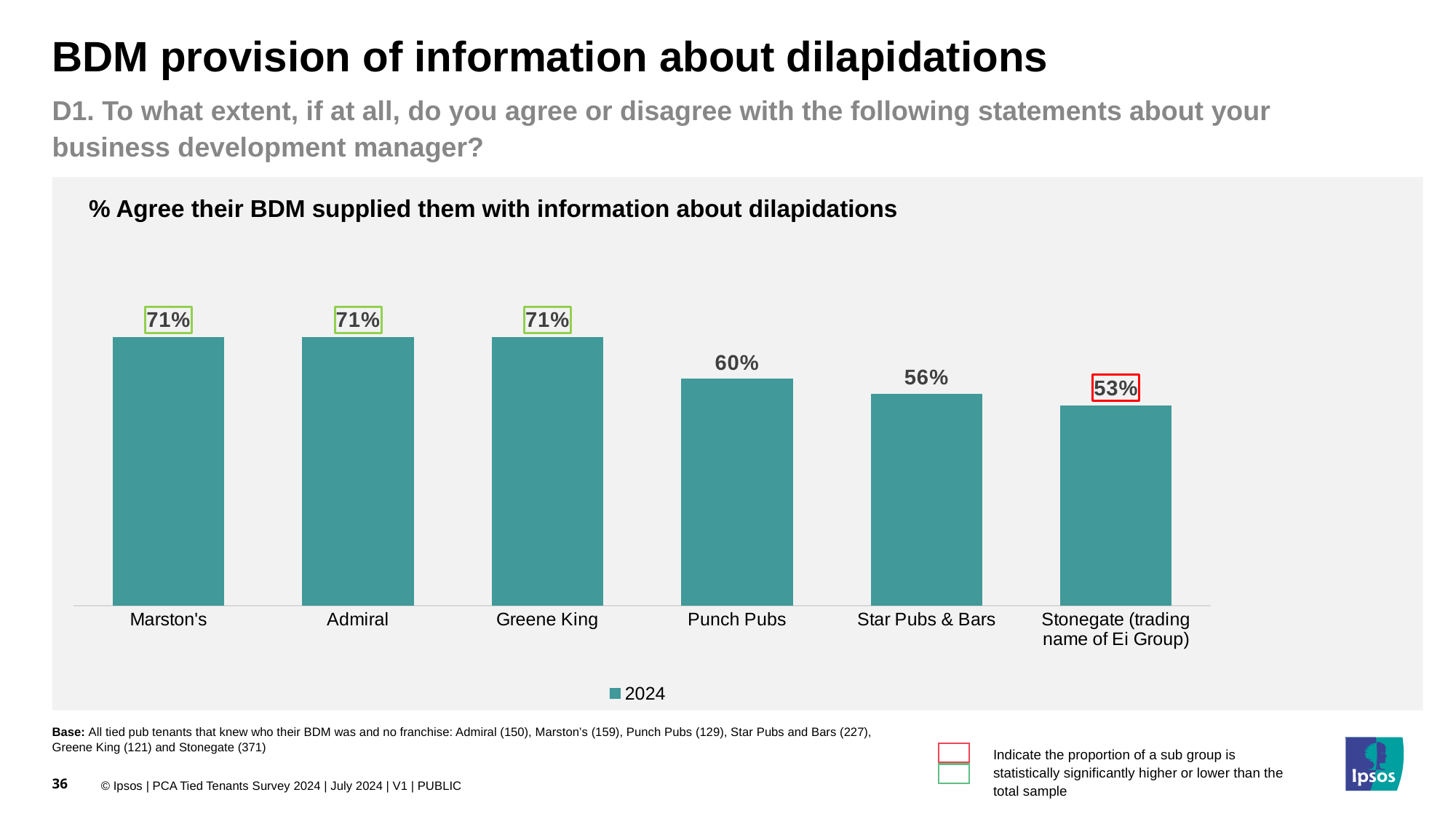
What is the value for Admiral? 71% Which is larger, the value for Greene King or the value for Punch Pubs? Greene King What is the value for Star Pubs & Bars? 56% What is the value for Punch Pubs? 60% What is the difference between the values for Punch Pubs and Star Pubs & Bars? 4% How many categories are shown on the x axis? 6 What kind of chart is shown? Bar chart How many series does the legend list? 1 What is the value for Stonegate (trading name of Ei Group)? 53% What is the difference between the values for Marston's and Stonegate (trading name of Ei Group)? 18% What is the title of the chart? % Agree their BDM supplied them with information about dilapidations Which category has the lowest value? Stonegate (trading name of Ei Group)